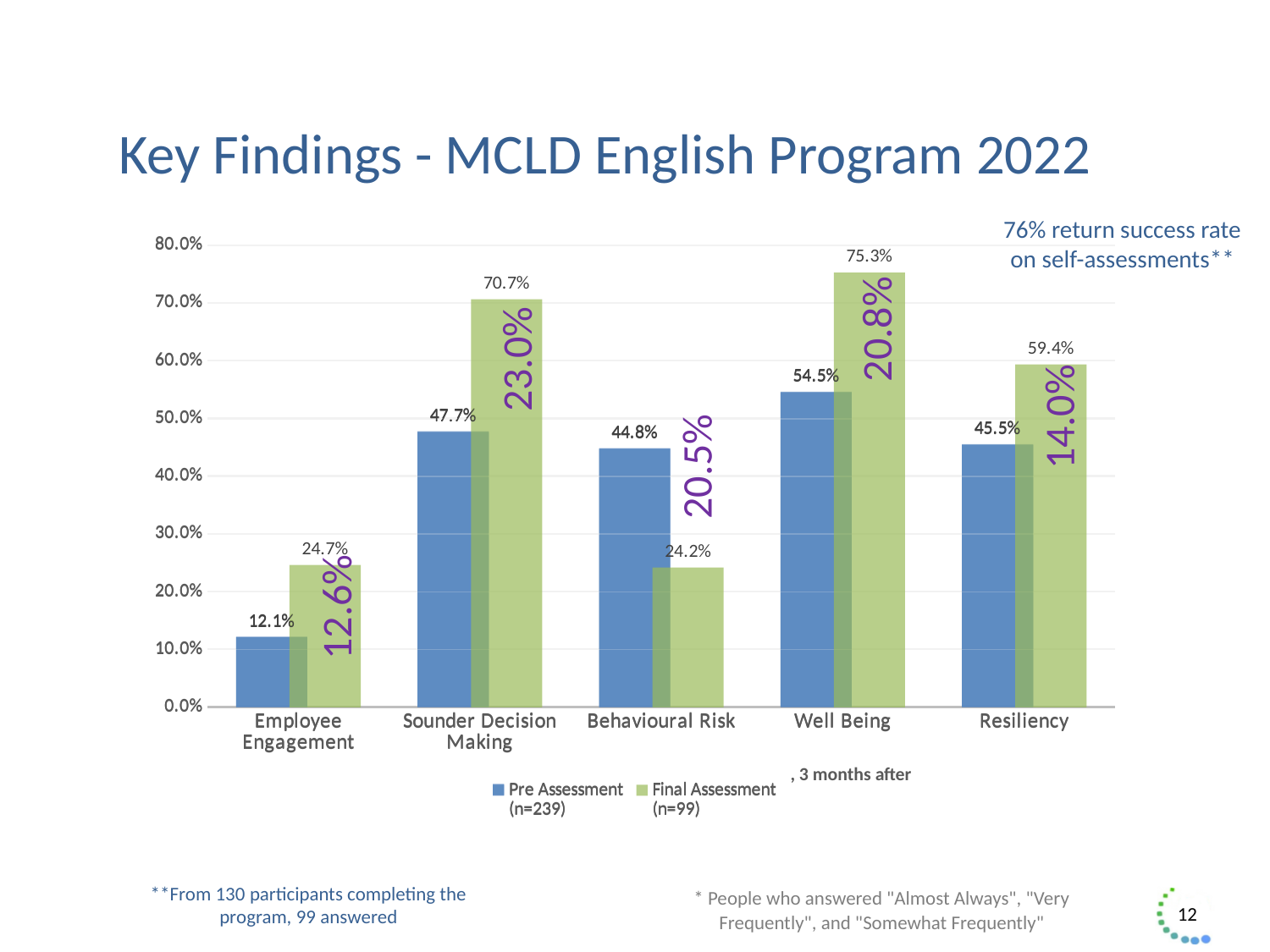
What is the difference between the Final Assessment and Pre Assessment values for Sounder Decision Making? 23.0% What is the Final Assessment value for Sounder Decision Making? 70.7% Is the Final Assessment value for Resiliency greater or less than 50.0%? greater What kind of chart is shown on the slide? Bar chart Which category has the highest Final Assessment value? Well Being How many series does the chart legend list? 2 What is the Final Assessment value for Well Being? 75.3% What is the Pre Assessment value for Employee Engagement? 12.1% How many categories are shown on the x axis of the chart? 5 Which category has the lowest Pre Assessment value? Employee Engagement What is the Pre Assessment value for Resiliency? 45.5% Which is larger for Behavioural Risk: the Pre Assessment value or the Final Assessment value? Pre Assessment